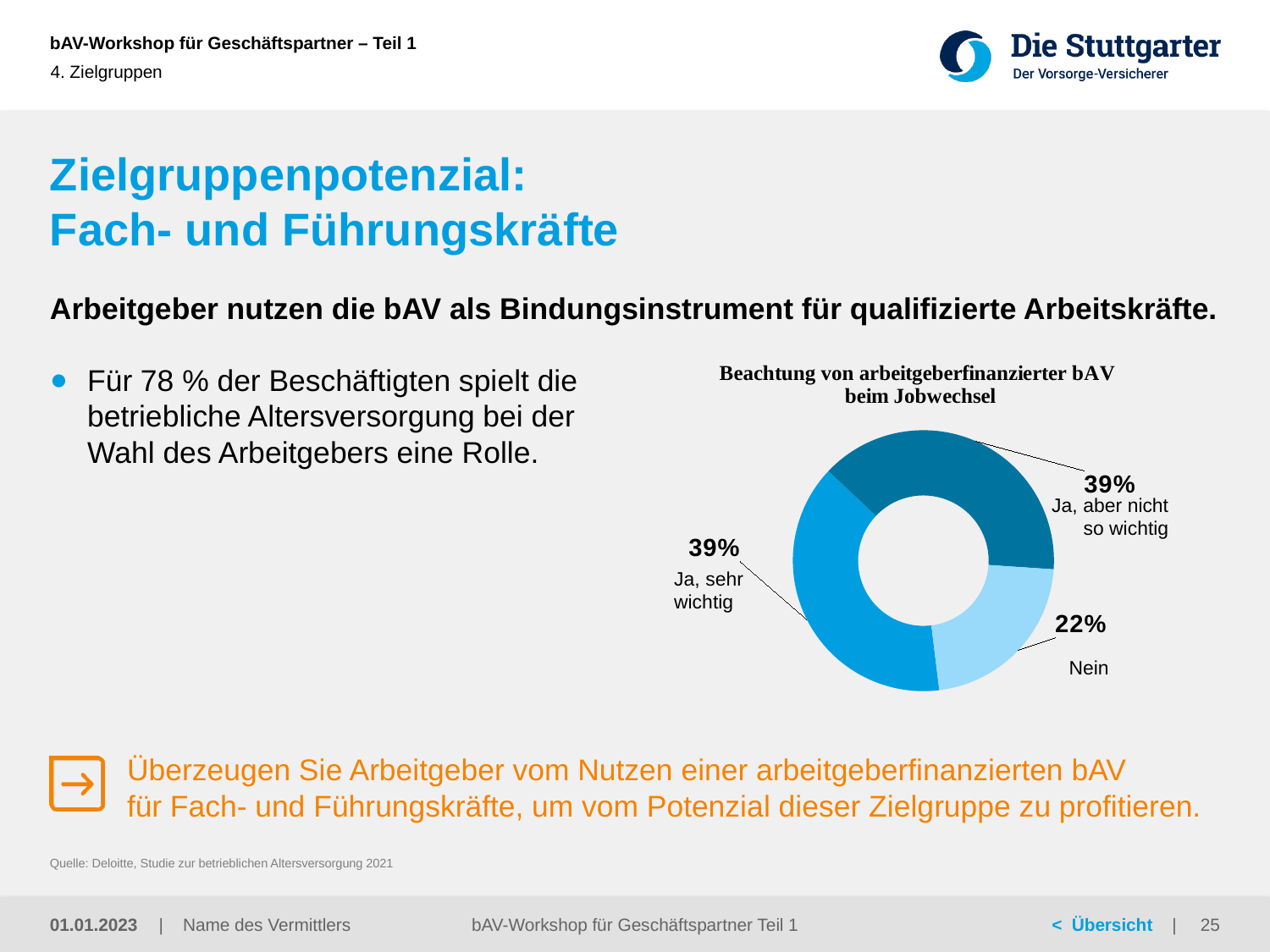
What is the title of the chart? Beachtung von arbeitgeberfinanzierter bAV beim Jobwechsel What is the combined share of the two "Ja" slices? 78% What percentage of the donut chart is labelled "Nein"? 22% Which two categories in the chart have the same value? Ja, sehr wichtig and Ja, aber nicht so wichtig How many slices does the chart have? 3 What value is shown for the slice "Ja, aber nicht so wichtig"? 39% Which category has the smallest share in the chart? Nein Is the share for "Nein" greater or less than 25%? less Which is larger: the share for "Nein" or the share for "Ja, aber nicht so wichtig"? Ja, aber nicht so wichtig What kind of chart is shown on the slide? Donut (pie) chart What value is shown for the slice "Ja, sehr wichtig"? 39% What is the difference in percentage points between "Ja, sehr wichtig" and "Nein"? 17 percentage points